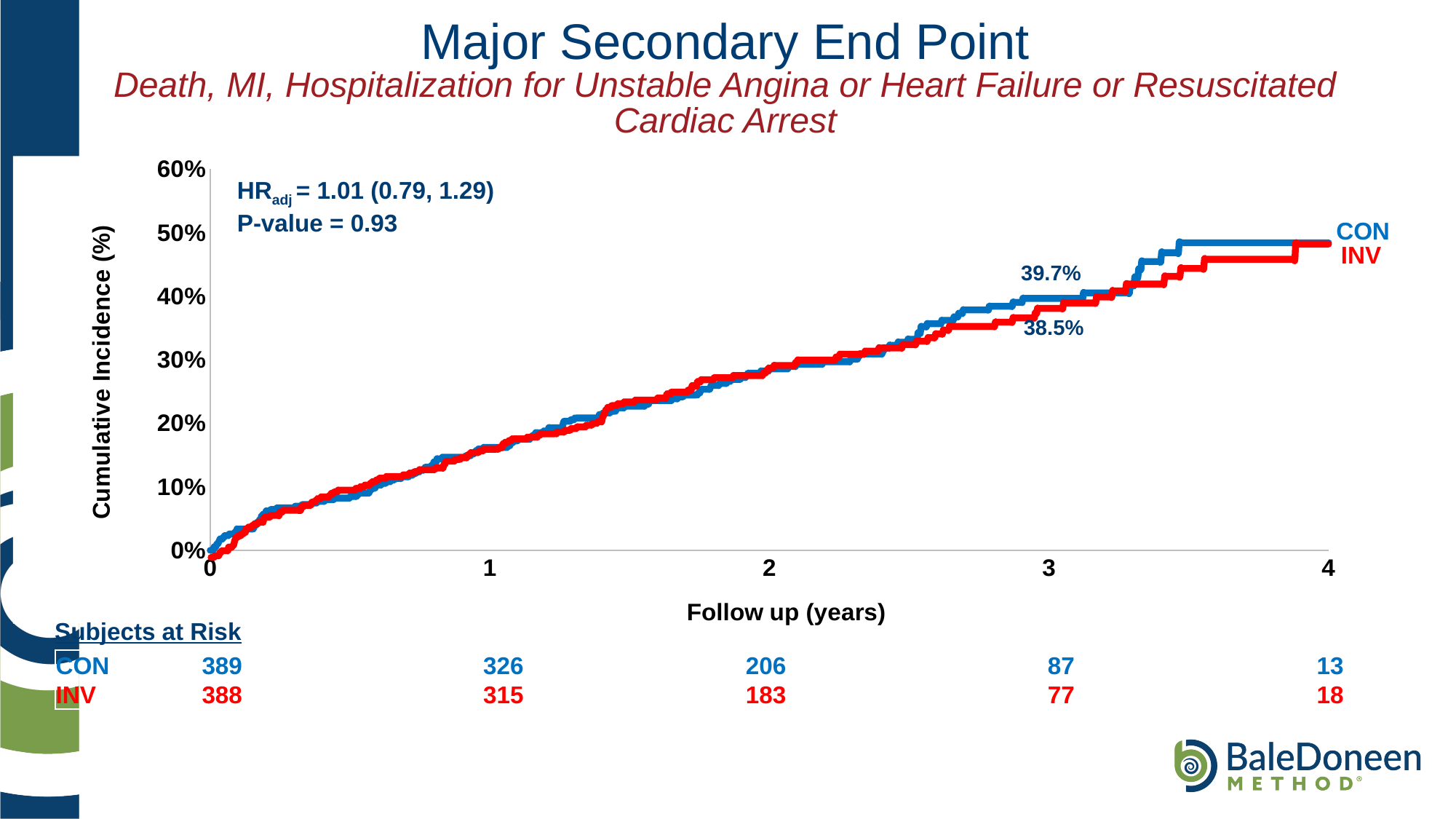
How many series (groups) are plotted on the chart? 2 Do the cumulative incidence curves rise or fall as follow-up time increases? rise What is the adjusted hazard ratio (HRadj) shown on the chart? 1.01 (0.79, 1.29) How many CON subjects are at risk at year 0? 389 At year 4, which group has more subjects at risk, CON or INV? INV What are the names of the two groups plotted on the chart? CON and INV What kind of chart is shown on the slide? line chart What are the two percentage values labeled on the chart near year 3? 39.7% and 38.5% What is the difference between the number of CON and INV subjects at risk at year 2? 23 How many INV subjects are at risk at year 2? 183 How many CON subjects are at risk at year 3? 87 Is the cumulative incidence for CON at year 2 greater or less than 20%? greater